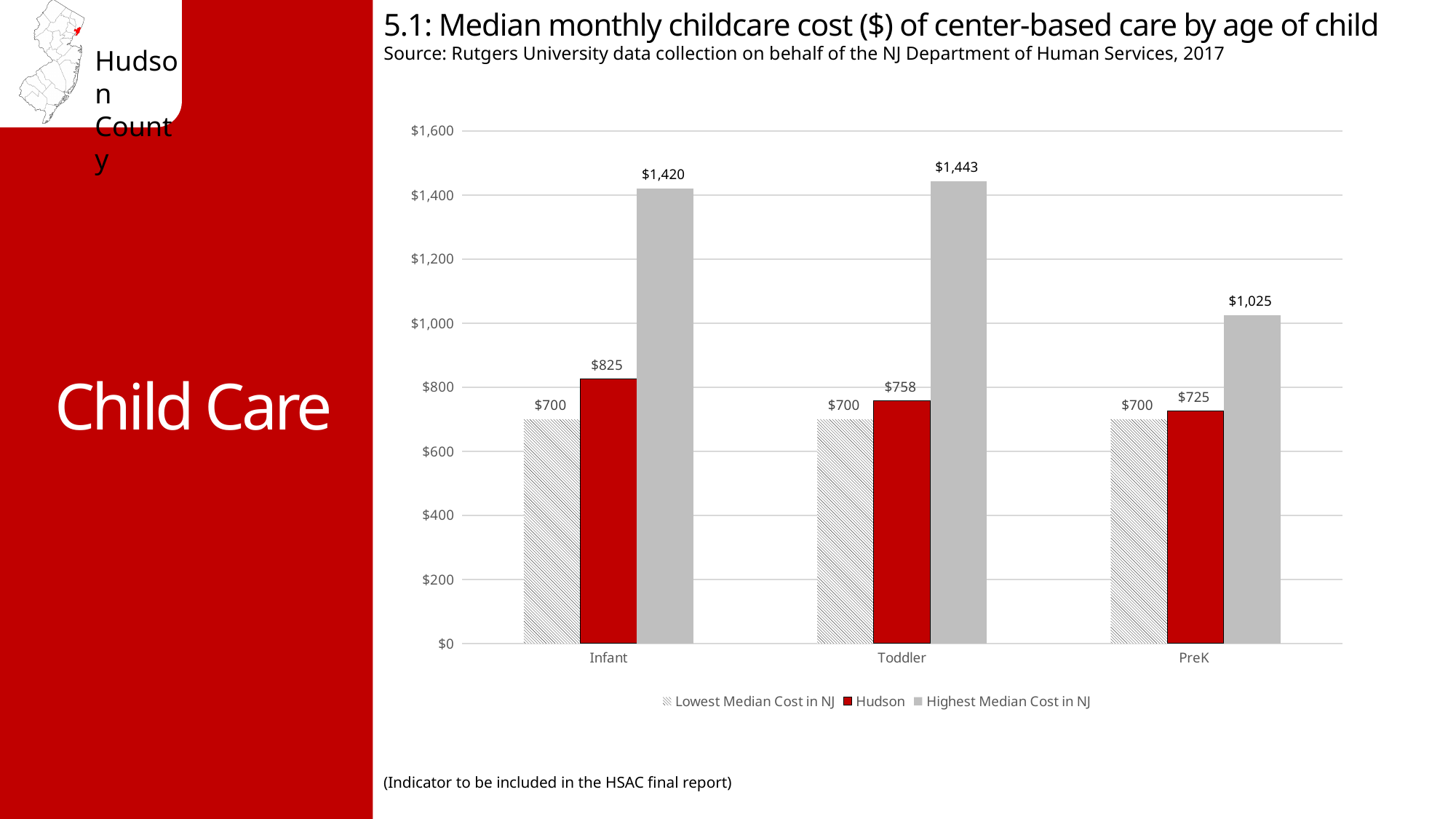
How many series does the legend list? 3 Do the Hudson values rise or fall from Infant to PreK? fall What is the difference between the Highest Median Cost in NJ and the Hudson cost for Infant care? $595 What is the Hudson median monthly childcare cost for Infant care? $825 Is the Hudson cost for Toddler care larger or smaller than the Hudson cost for PreK care? larger How many age groups are shown on the x axis? 3 Is the Highest Median Cost in NJ for PreK care greater or less than $1,200? less What is the Highest Median Cost in NJ for Toddler care? $1,443 Which age group has the highest Hudson median monthly cost? Infant Which age group has the lowest Highest Median Cost in NJ? PreK What kind of chart is shown on the slide? bar chart What is the Lowest Median Cost in NJ for PreK care? $700